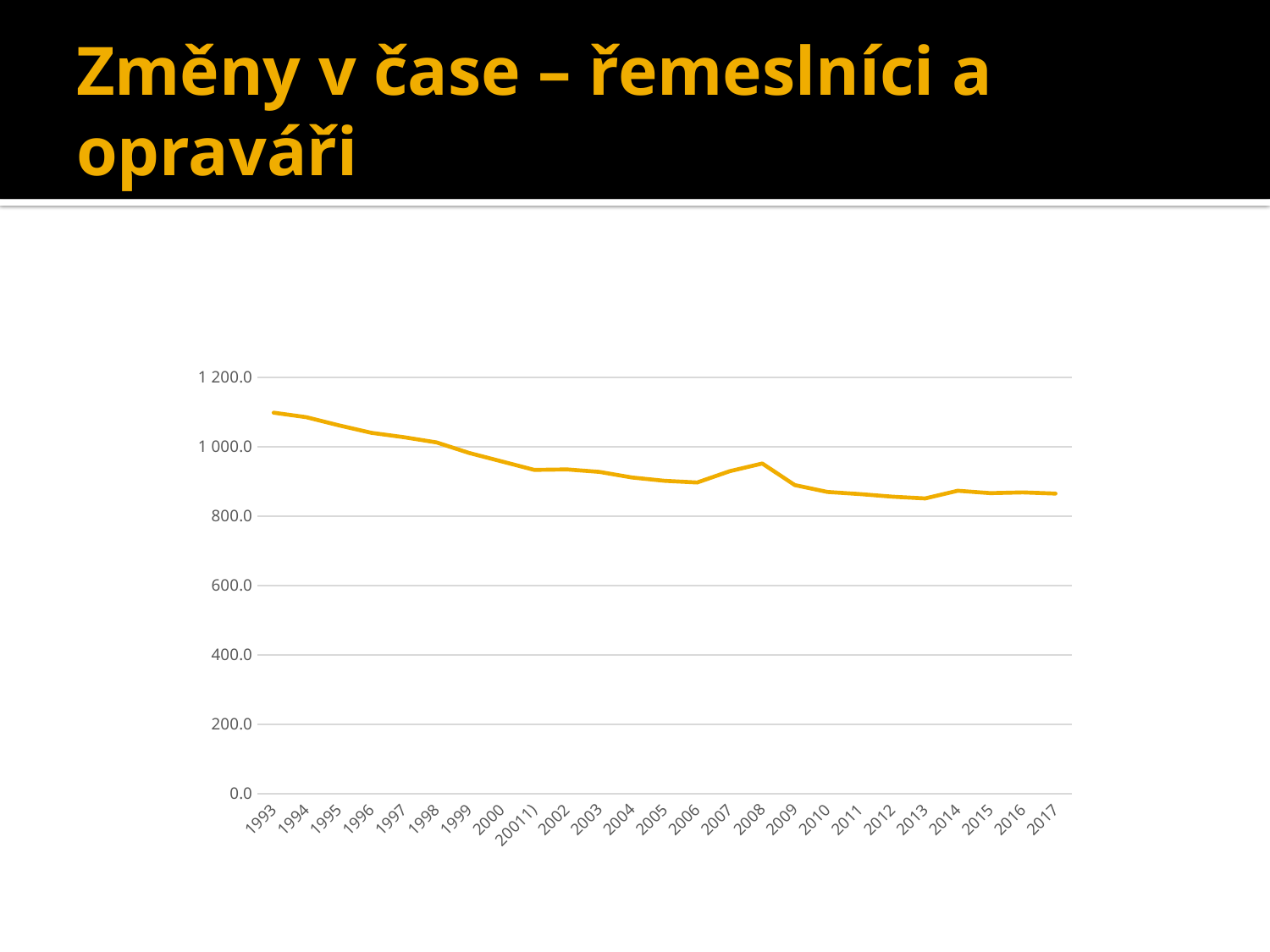
Is the value for 1993 greater or less than 1000? greater Which year has the larger value, 1993 or 2017? 1993 How many years are shown on the x axis of the chart? 25 Is the value for 2013 greater or less than 1000? less Which year has the larger value, 2008 or 2009? 2008 Is the value for 2008 greater or less than 1000? less What is the highest tick value shown on the y axis? 1 200.0 What is the title of the slide containing the chart? Změny v čase – řemeslníci a opraváři Do the values generally rise or fall from 1993 to 2017? fall Which year has the highest value on the chart? 1993 What kind of chart is shown on the slide? line chart